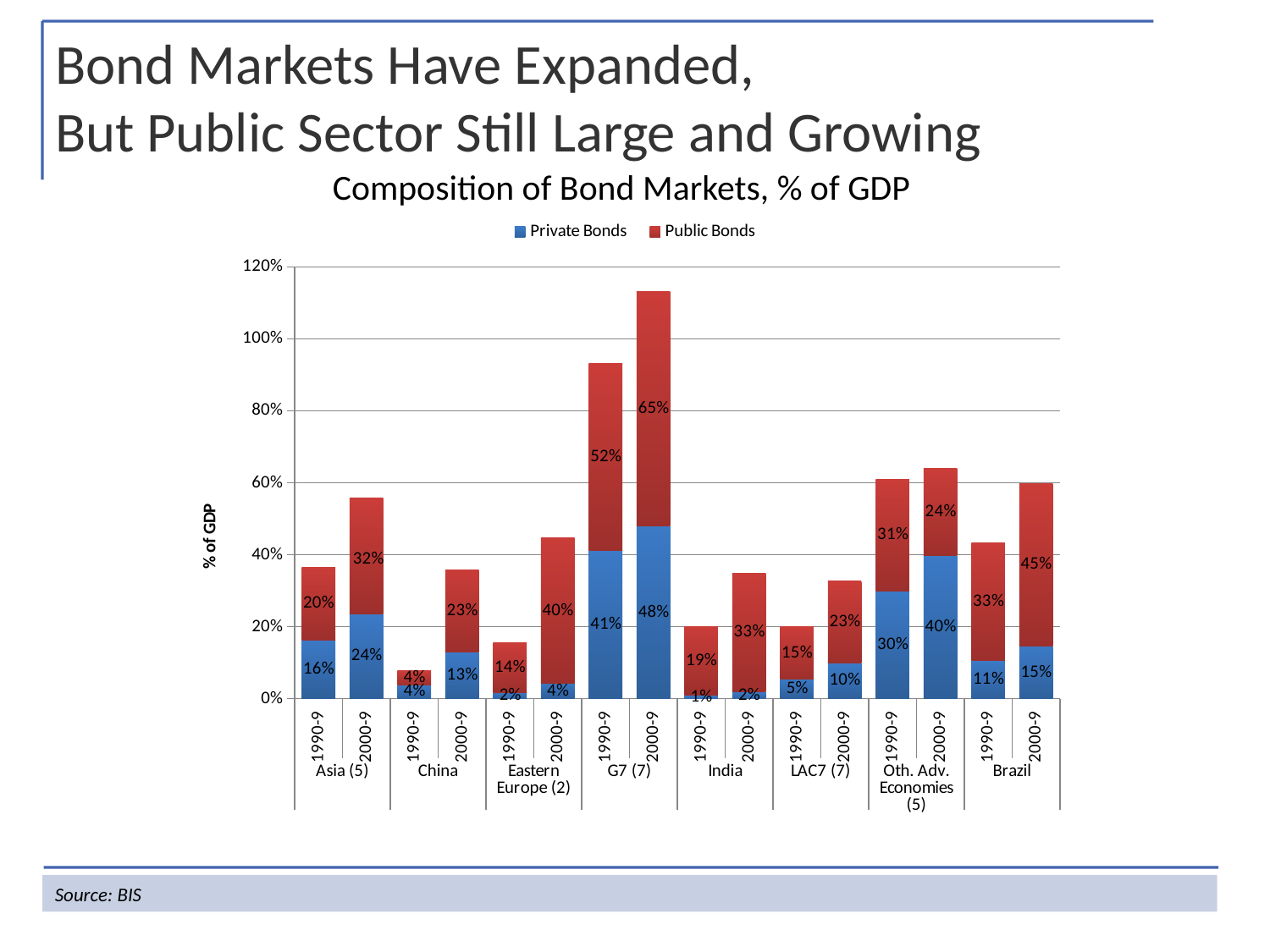
How many series does the legend list? 2 What is the Public Bonds value for Brazil in 2000-9? 45% Which bar has the lowest Private Bonds value? India 1990-9 Which bar has the highest Public Bonds value? G7 (7) 2000-9 What is the difference between the Public Bonds values for India in 2000-9 and 1990-9? 14% What is the total of the stacked bar for G7 (7) in 2000-9? 113% What is the Public Bonds value for Eastern Europe (2) in 1990-9? 14% What is the Private Bonds value for G7 (7) in 2000-9? 48% Which is larger for Oth. Adv. Economies (5) in 2000-9: Private Bonds or Public Bonds? Private Bonds What type of chart is shown on the slide? Stacked bar chart What is the total of the stacked bar for Brazil in 2000-9? 60% How many country groups are shown on the x axis? 8